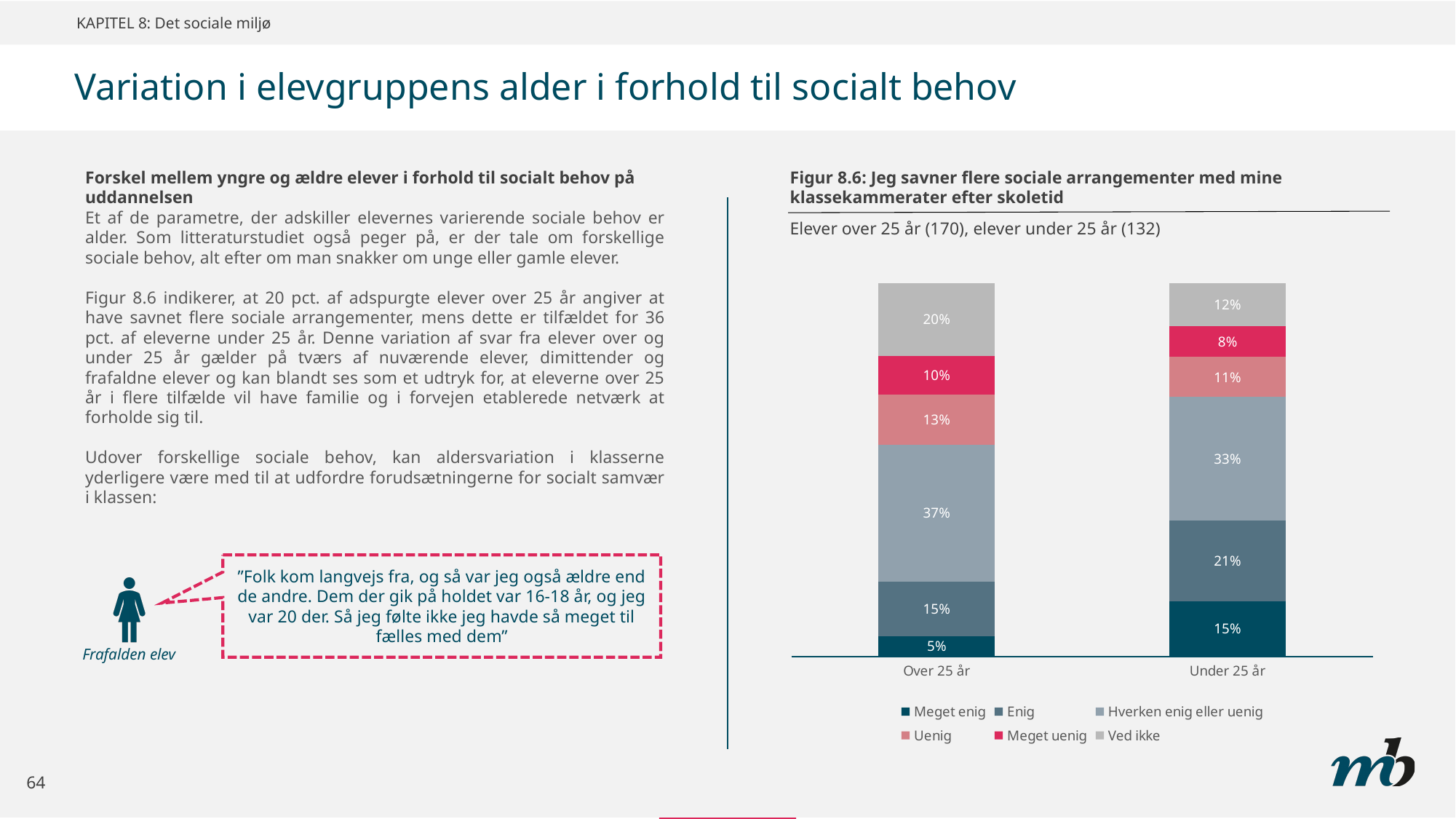
What is the value for "Enig" in the "Under 25 år" bar? 21% What is the difference between the "Meget enig" values for "Under 25 år" and "Over 25 år"? 10% How many categories are shown on the x axis? 2 Which series has the largest segment in the "Over 25 år" bar? Hverken enig eller uenig What kind of chart is shown? Stacked bar chart What is the value for "Ved ikke" in the "Over 25 år" bar? 20% Which series has the smallest segment in the "Over 25 år" bar? Meget enig What is the total of the "Under 25 år" stacked bar? 100% What is the value for "Meget enig" in the "Over 25 år" bar? 5% Which category has the larger "Ved ikke" value, "Over 25 år" or "Under 25 år"? Over 25 år How many series does the legend list? 6 What is the value for "Hverken enig eller uenig" in the "Under 25 år" bar? 33%